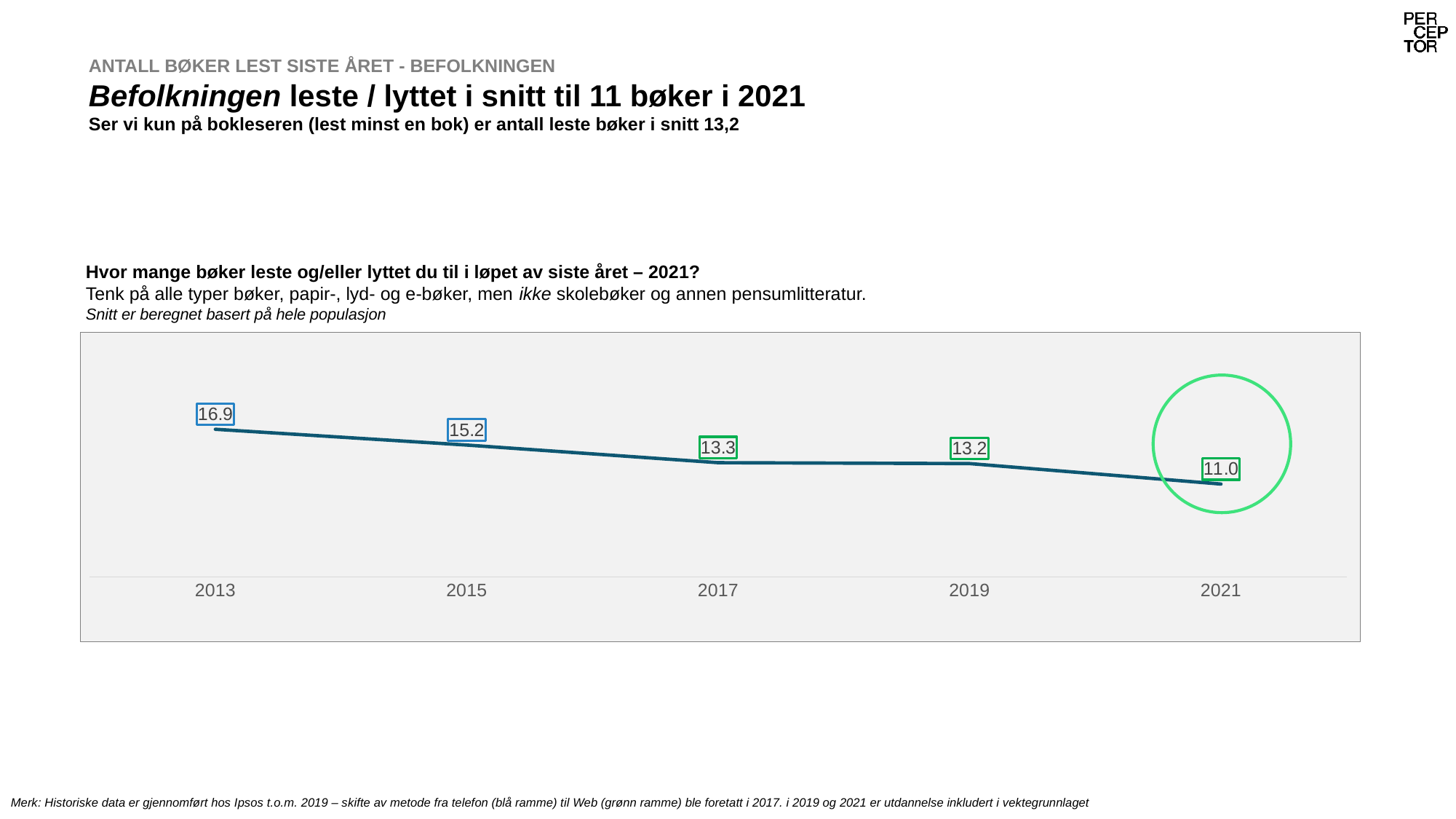
Which year has the highest value? 2013 What kind of chart is shown? line chart What is the difference between the values for 2015 and 2017? 1.9 Which data point is highlighted with a green circle? 2021 Which is larger, the value for 2015 or the value for 2019? 2015 Do the values rise or fall from 2013 to 2021? fall What is the difference between the values for 2013 and 2021? 5.9 Which year has the lowest value? 2021 What is the value for 2017? 13.3 What is the value for 2021? 11.0 How many years are plotted on the chart? 5 What is the value for 2013? 16.9